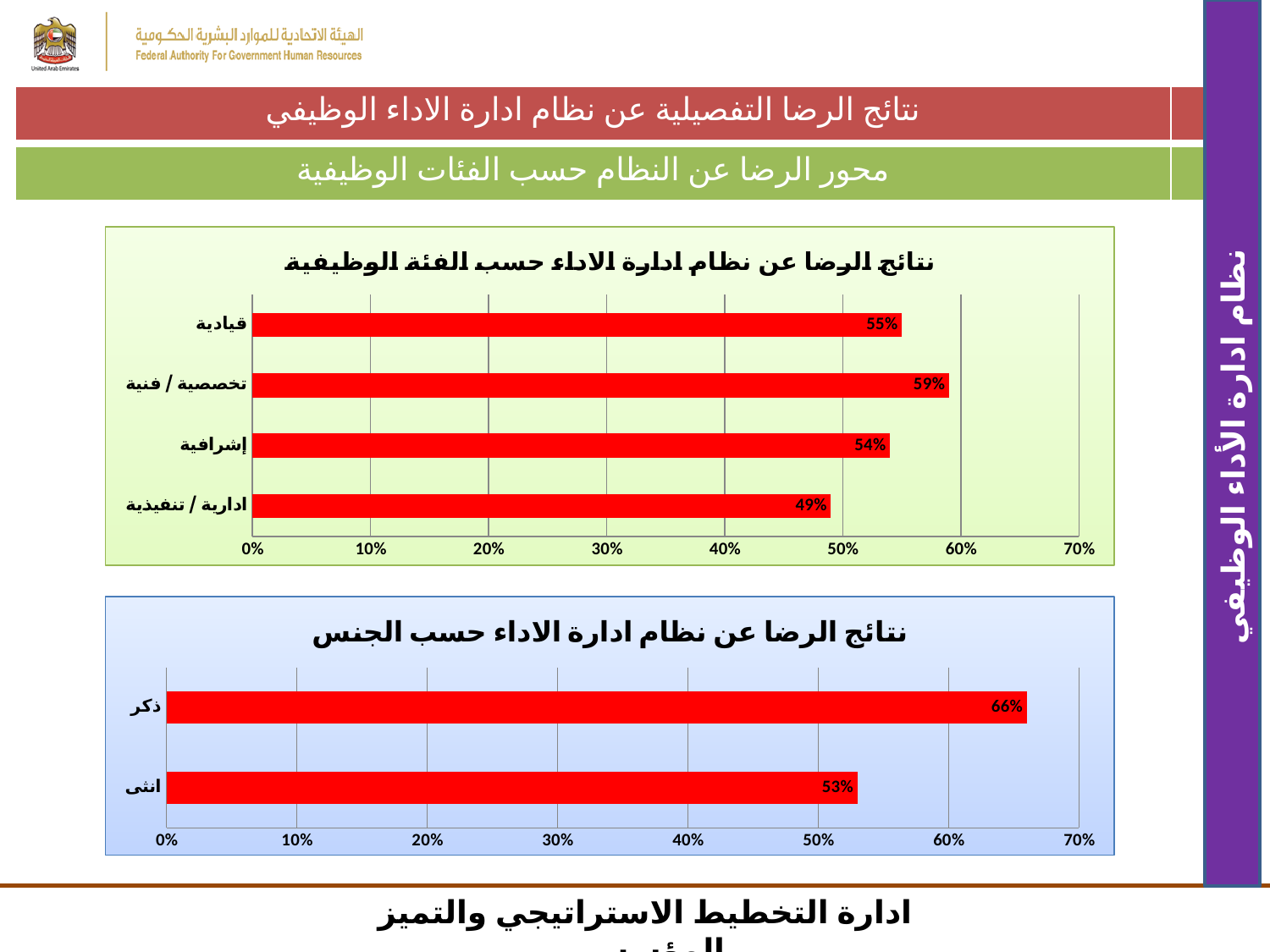
In the top chart (satisfaction by job category), which category has the highest value? تخصصية / فنية In the bottom chart (satisfaction by gender), what is the value for انثى? 53% In the top chart (satisfaction by job category), what is the difference between the values for قيادية and إشرافية? 1% What type of chart is the bottom chart (satisfaction by gender)? Bar chart In the bottom chart (satisfaction by gender), which is larger, the value for ذكر or انثى? ذكر In the top chart (satisfaction by job category), how many categories are shown? 4 In the bottom chart (satisfaction by gender), what is the value for ذكر? 66% In the bottom chart (satisfaction by gender), what is the difference between the values for ذكر and انثى? 13% In the top chart (satisfaction by job category), is the value for قيادية greater or less than 50%? greater In the top chart (satisfaction by job category), which category has the lowest value? ادارية / تنفيذية In the top chart (satisfaction by job category), what is the value for ادارية / تنفيذية? 49% In the top chart (satisfaction by job category), what is the value for تخصصية / فنية? 59%